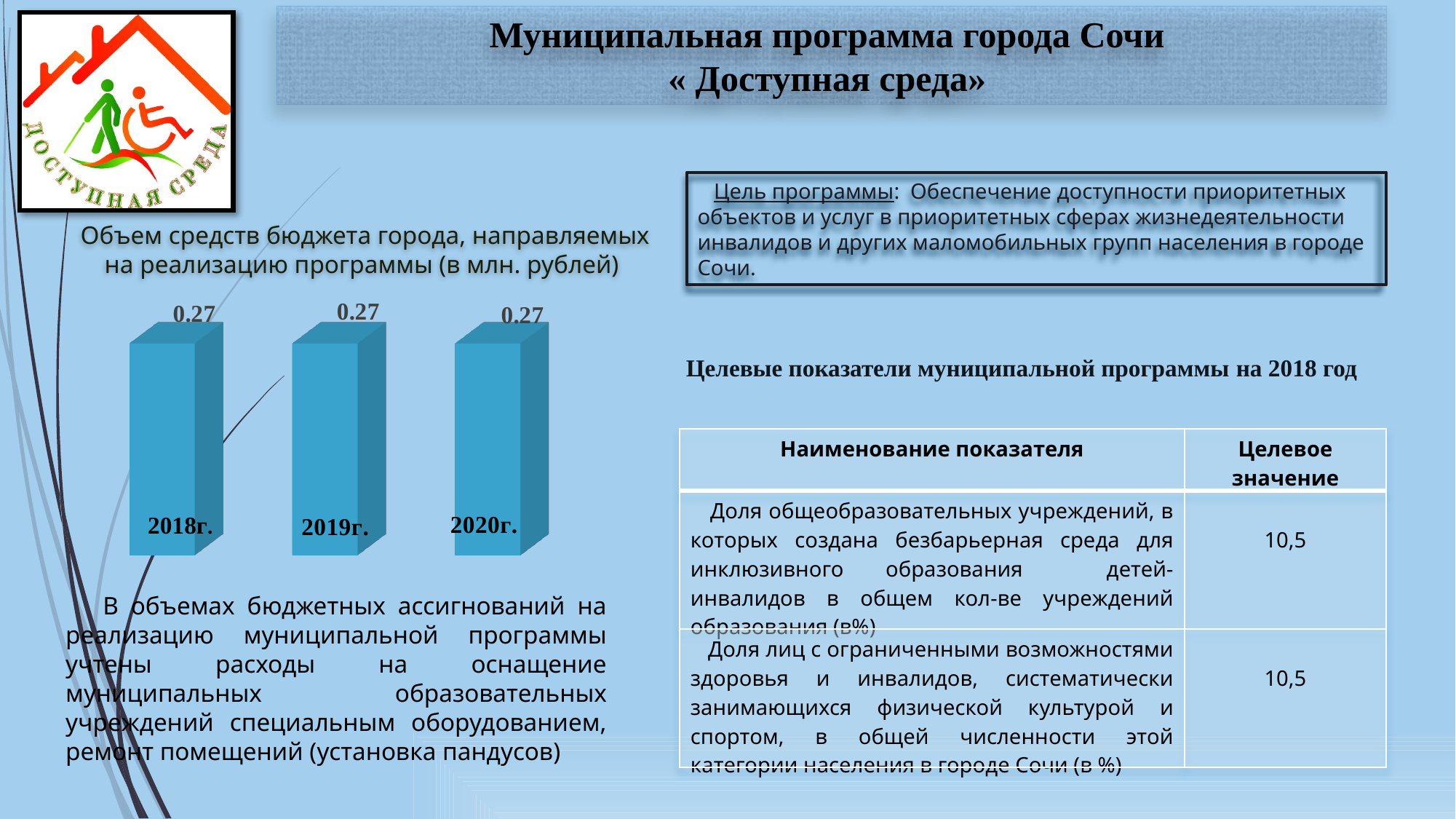
How many bars (years) are shown in the chart? 3 What is the value for 2020г. in the bar chart? 0.27 What is the value for 2018г. in the bar chart? 0.27 Is the value for 2019г. larger than, smaller than, or equal to the value for 2020г.? Equal Do the values in the chart rise, fall, or stay the same from 2018г. to 2020г.? Stay the same What kind of chart is shown on the slide? Bar chart What is the title of the bar chart? Объем средств бюджета города, направляемых на реализацию программы (в млн. рублей) What is the difference between the values for 2018г. and 2020г.? 0 What is the value for 2019г. in the bar chart? 0.27 Which year is the first category on the x axis of the chart? 2018г. In what units are the chart values expressed, according to the chart title? млн. рублей